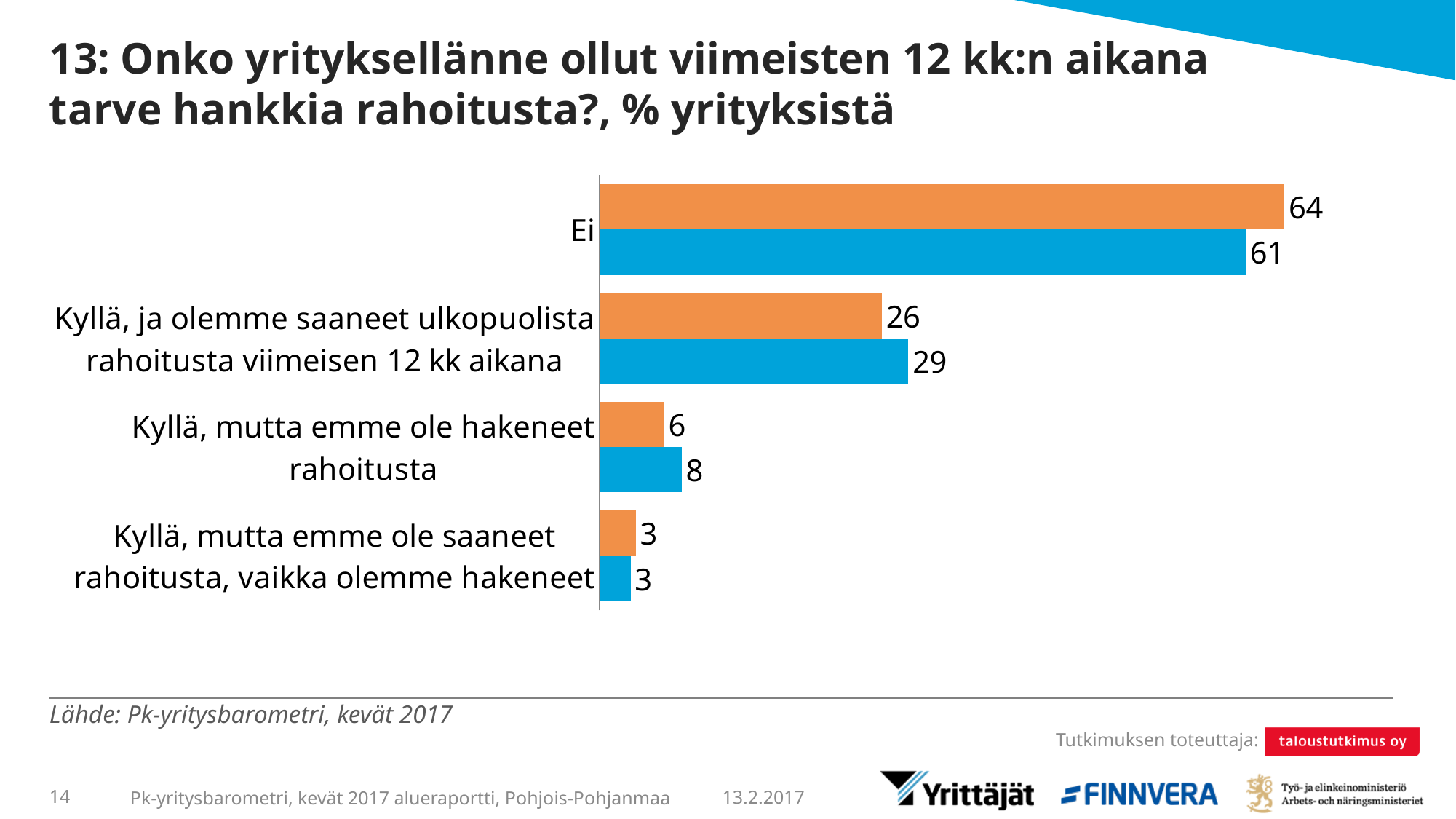
What is the value of the orange bar for "Ei"? 64 What is the value of the blue bar for "Ei"? 61 How many categories are shown on the chart? 4 What is the value of the blue bar for "Kyllä, mutta emme ole hakeneet rahoitusta"? 8 What type of chart is shown on the slide? bar chart What is the difference between the orange and blue bar values for "Ei"? 3 What is the value of the blue bar for "Kyllä, mutta emme ole saaneet rahoitusta, vaikka olemme hakeneet"? 3 Which category has the lowest blue bar value? Kyllä, mutta emme ole saaneet rahoitusta, vaikka olemme hakeneet What is the source cited below the chart? Pk-yritysbarometri, kevät 2017 For "Kyllä, ja olemme saaneet ulkopuolista rahoitusta viimeisen 12 kk aikana", which is larger, the orange bar or the blue bar? the blue bar Which category has the highest orange bar value? Ei What is the value of the orange bar for "Kyllä, ja olemme saaneet ulkopuolista rahoitusta viimeisen 12 kk aikana"? 26